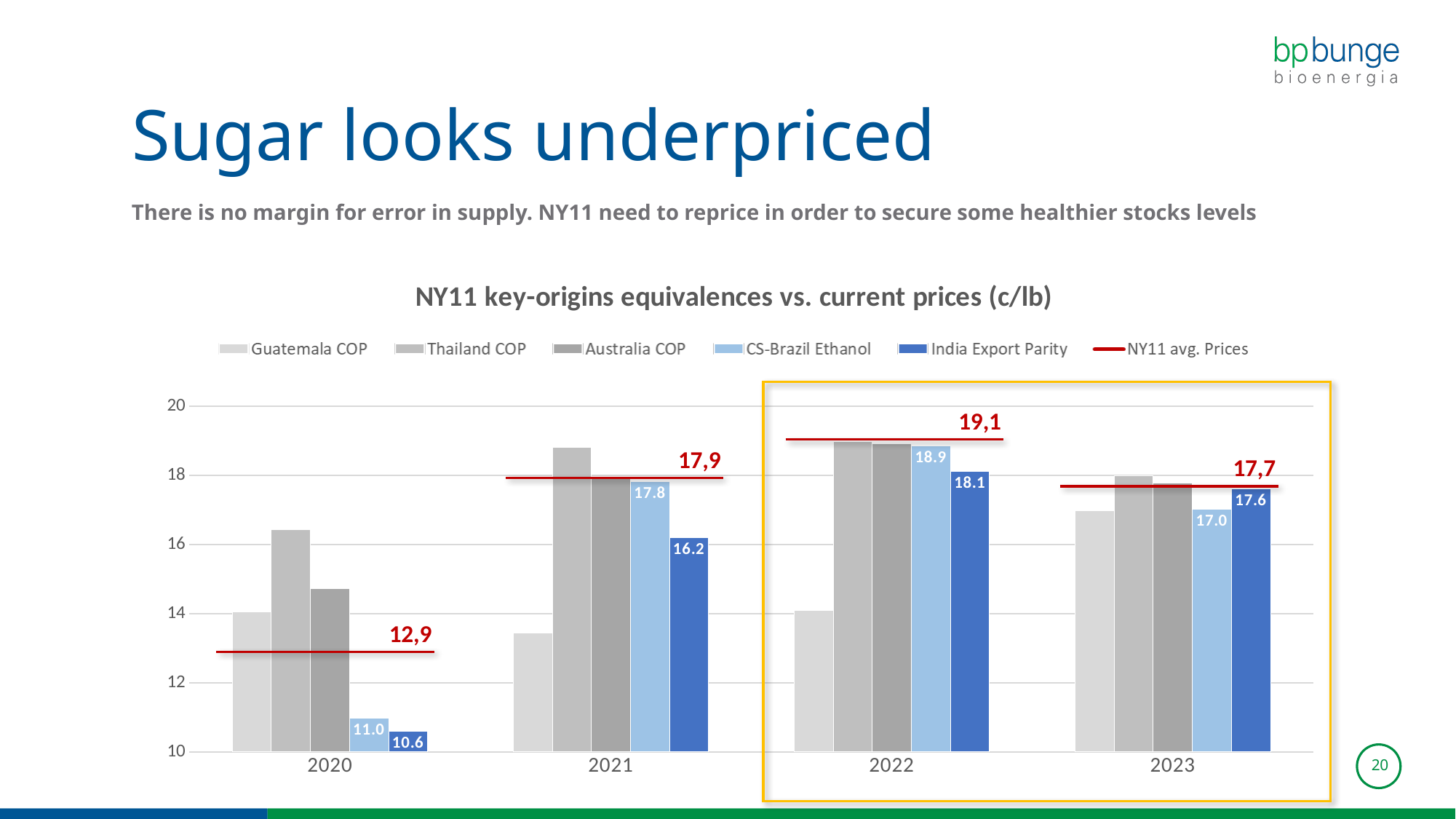
How many years are shown on the x axis? 4 What is the value for CS-Brazil Ethanol in 2021? 17.8 What is the NY11 avg. Prices value shown for 2020? 12,9 Which year has the larger India Export Parity value, 2021 or 2023? 2023 Does the India Export Parity value rise or fall from 2020 to 2022? rise In which year is the India Export Parity value lowest? 2020 What is the India Export Parity value in 2022? 18.1 Is the value for Guatemala COP in 2021 greater or less than 14? less In which year is the NY11 avg. Prices value highest? 2022 What kind of chart is used to show the key-origins equivalences? bar chart How many series does the legend list? 6 What is the difference between the CS-Brazil Ethanol values for 2022 and 2023? 1.9